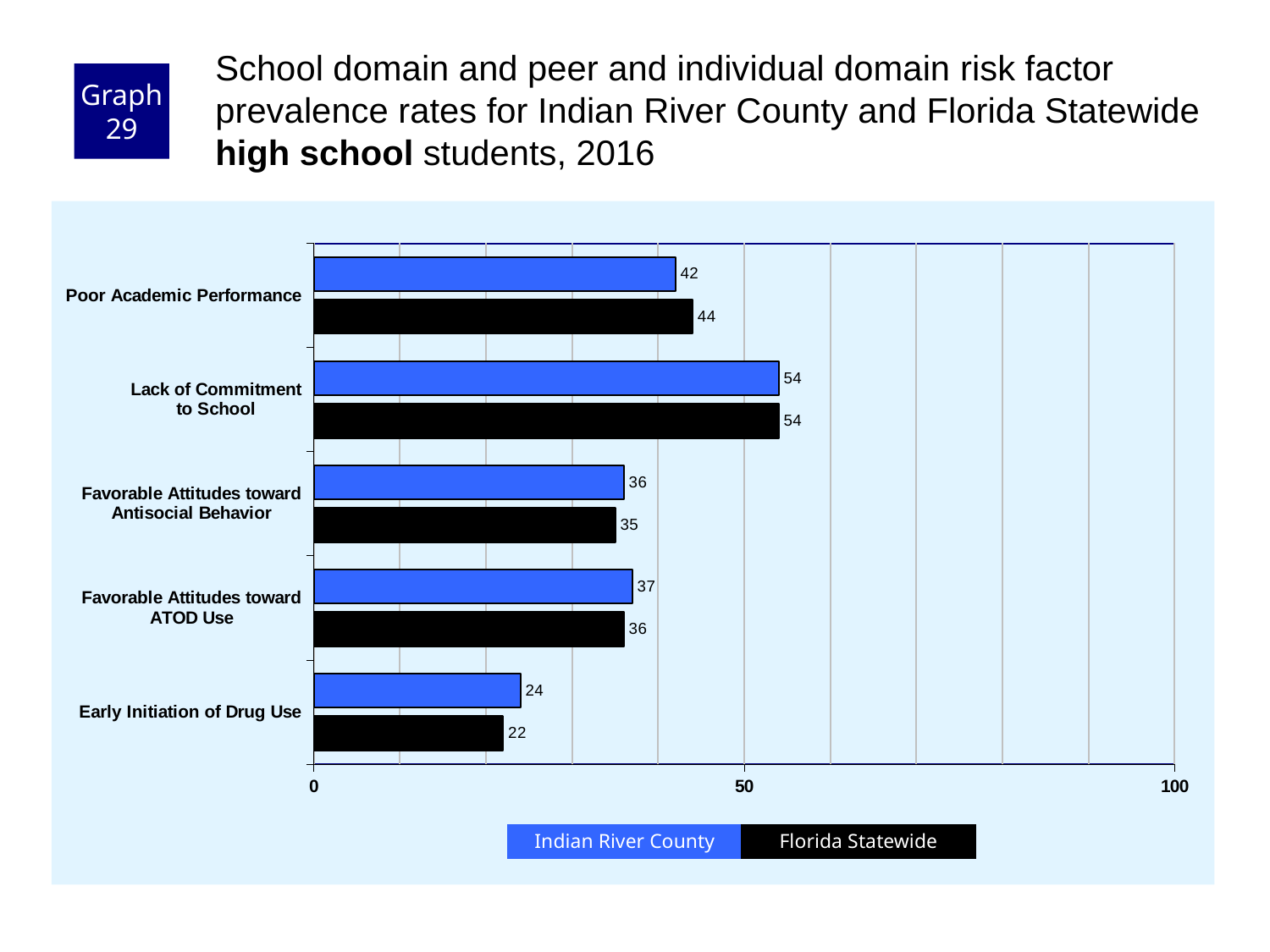
What is the Florida Statewide value for Early Initiation of Drug Use? 22 Which risk factor has the highest Indian River County value? Lack of Commitment to School Which colour represents Florida Statewide in the chart? black What kind of chart is shown on the slide? bar chart Is the Indian River County value for Lack of Commitment to School greater or less than 50? greater What is the difference between the Florida Statewide and Indian River County values for Poor Academic Performance? 2 For Early Initiation of Drug Use, which is larger: the Indian River County value or the Florida Statewide value? Indian River County How many risk factor categories are shown on the chart? 5 What is the Indian River County value for Poor Academic Performance? 42 What is the Florida Statewide value for Favorable Attitudes toward Antisocial Behavior? 35 Which risk factor has the lowest Florida Statewide value? Early Initiation of Drug Use How many series does the legend list? 2